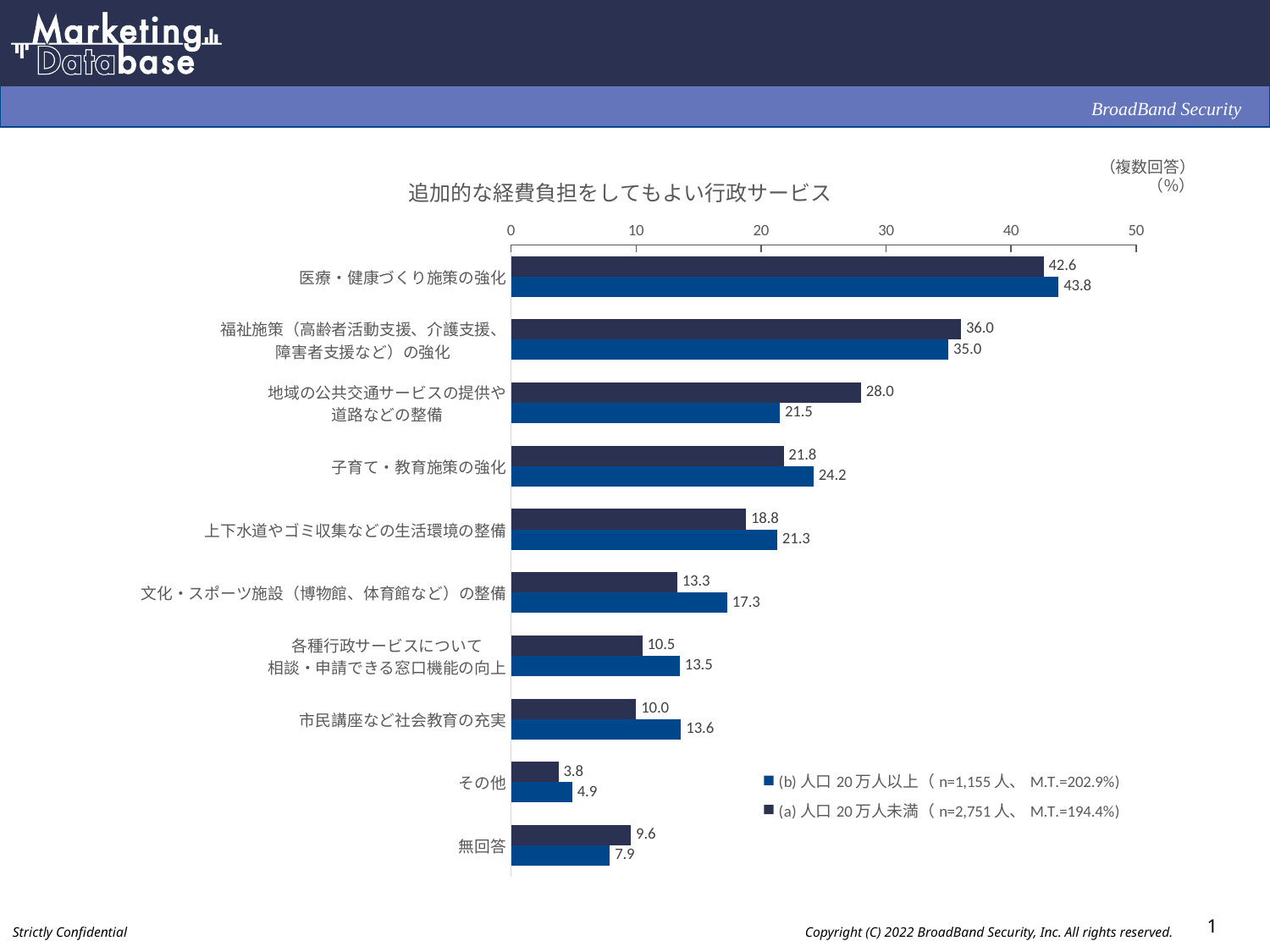
What is the value for 地域の公共交通サービスの提供や道路などの整備 in the (b) 人口20万人以上 series? 21.5 What type of chart is shown on the slide? Bar chart For 子育て・教育施策の強化, which series has the larger value, (b) 人口20万人以上 or (a) 人口20万人未満? (b) 人口20万人以上 Is the value for 福祉施策（高齢者活動支援、介護支援、障害者支援など）の強化 in the (b) 人口20万人以上 series greater or less than 30? greater What is the title of the chart? 追加的な経費負担をしてもよい行政サービス What is the difference between the (b) 人口20万人以上 and (a) 人口20万人未満 values for 地域の公共交通サービスの提供や道路などの整備? 6.5 How many categories are plotted on the chart? 10 How many series does the legend list? 2 What is the value for 医療・健康づくり施策の強化 in the (a) 人口20万人未満 series? 42.6 What is the value for 市民講座など社会教育の充実 in the (a) 人口20万人未満 series? 10.0 Which category has the lowest value in the (a) 人口20万人未満 series? その他 Which category has the highest value in the (b) 人口20万人以上 series? 医療・健康づくり施策の強化